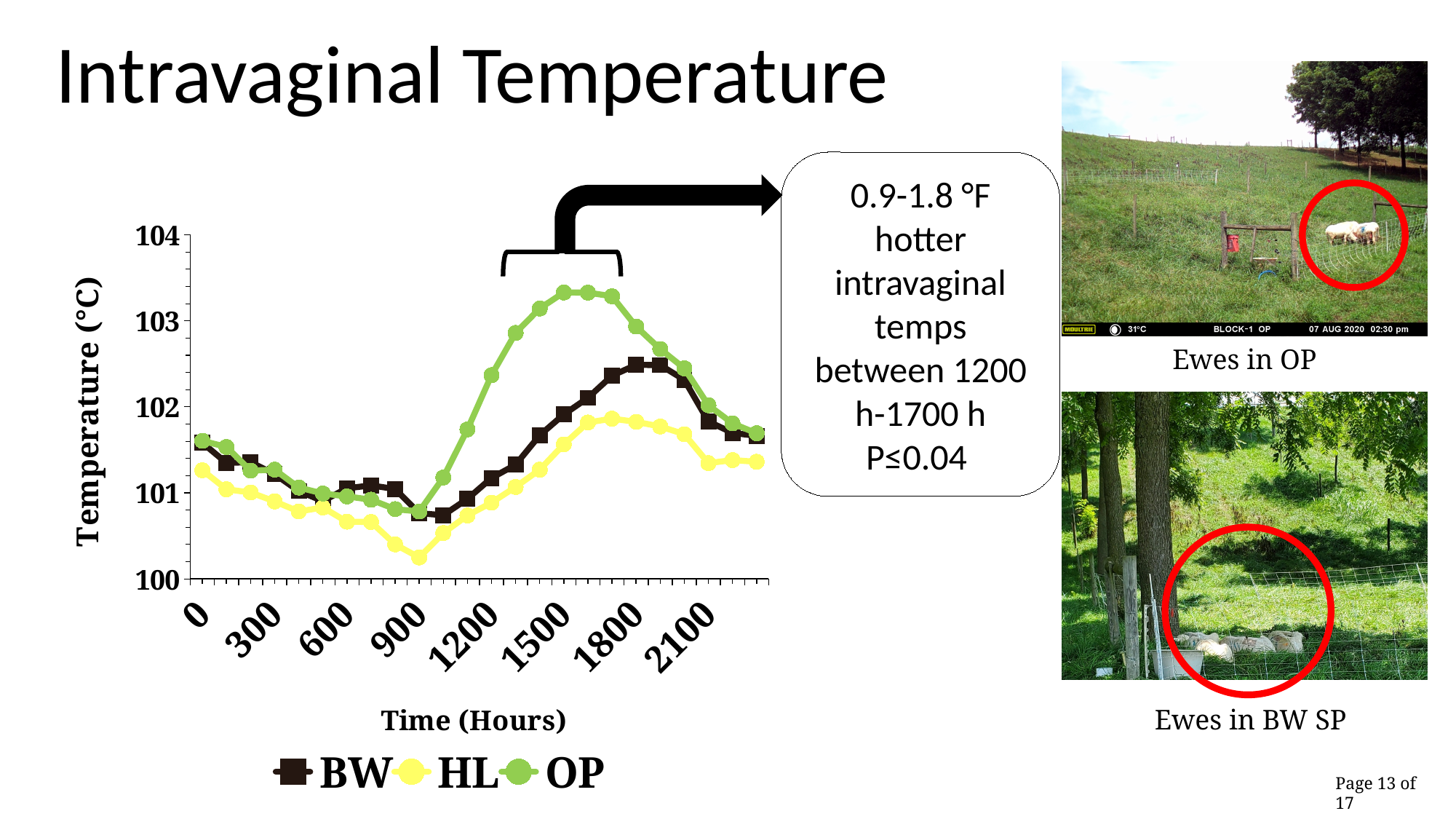
Between 900 and 1500 hours, do the OP values rise or fall? rise What are the series names listed in the chart's legend? BW, HL, OP Is the HL value at 1500 hours greater or less than 102? less What is the title of the chart's vertical axis? Temperature (°C) What kind of chart is shown on the slide? line chart Is the OP value at 1500 hours greater or less than 103? greater Is the BW value at 1800 hours greater or less than 102? greater Which series reaches the highest temperature on the chart? OP How many series does the chart's legend list? 3 Which series has the lowest temperature at around 900 hours? HL At 1500 hours, which series has the higher temperature, OP or BW? OP